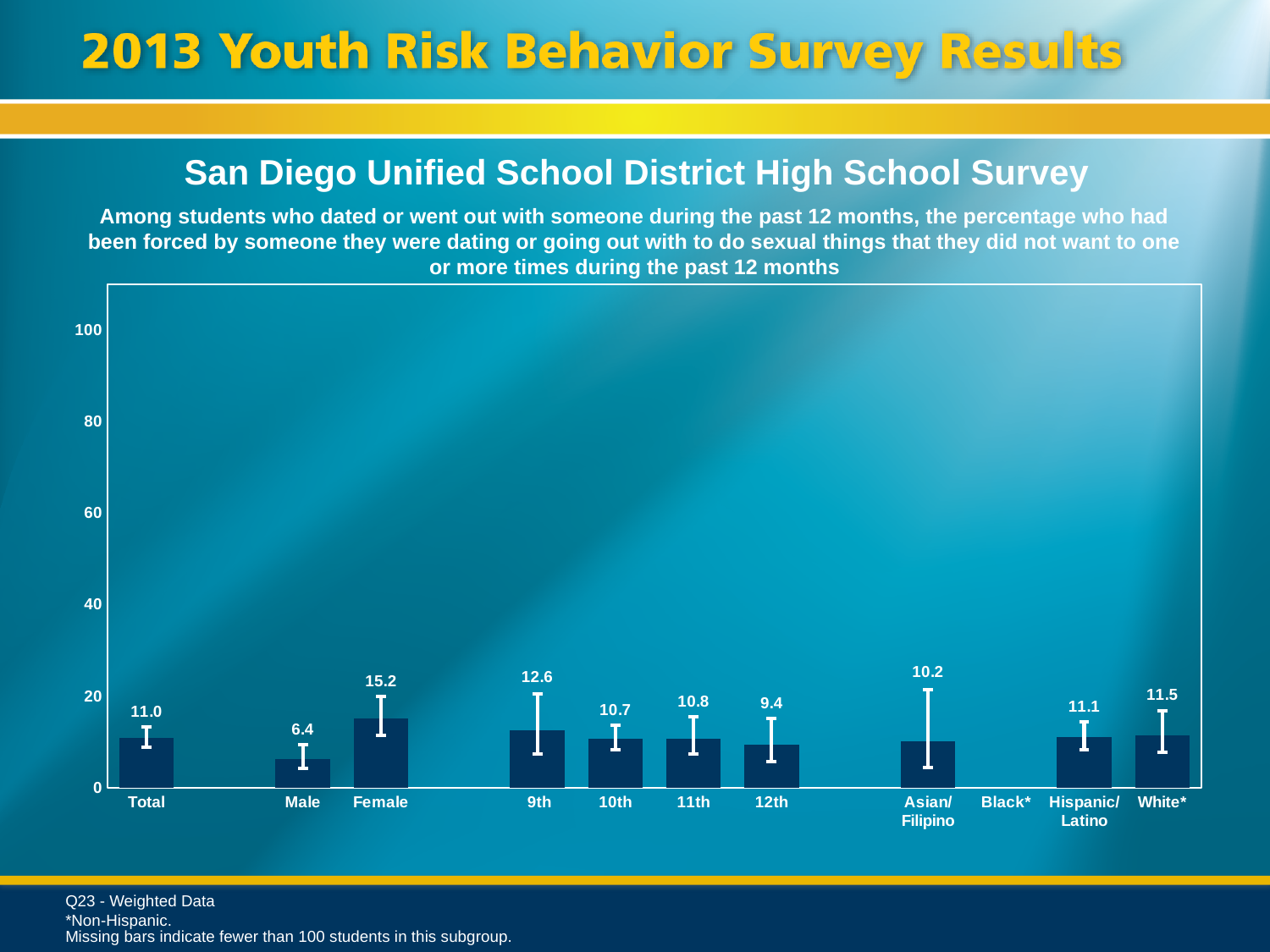
What is the difference between the Female and Male values? 8.8 What is the value for Female? 15.2 What is the value for Asian/Filipino? 10.2 Which is larger, the value for 10th grade or 11th grade? 11th What kind of chart is shown? bar chart Is the value for White* greater or less than 20? less What is the value for 9th grade? 12.6 Which category has the highest value? Female How many categories have a bar plotted? 10 Which category has no bar shown? Black* What is the value for Total? 11.0 Which category has the lowest value among the bars shown? Male